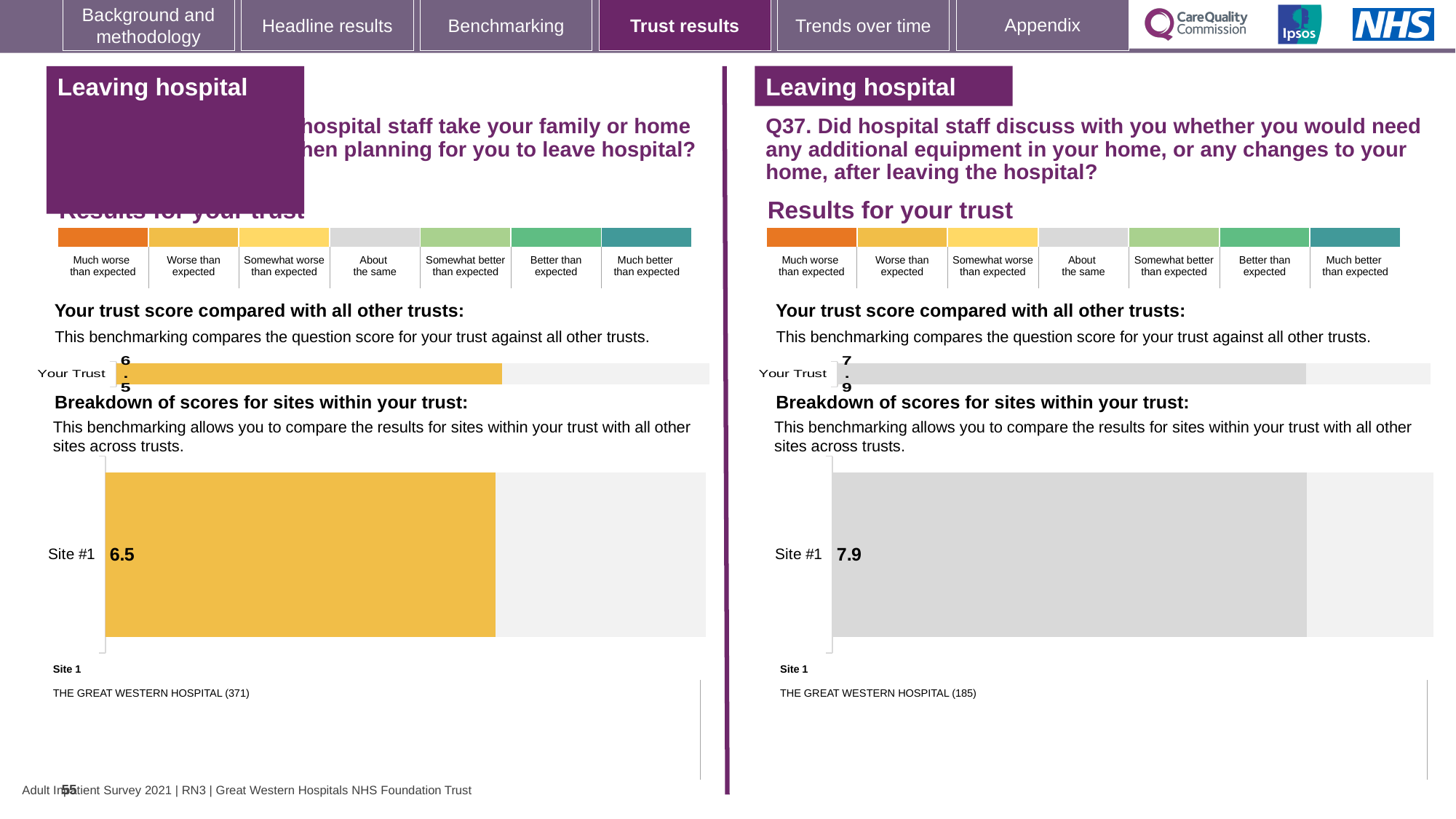
On the left half of the slide, what is the score shown for Your Trust? 6.5 Which site name is listed as Site 1 under the right chart (Q37)? THE GREAT WESTERN HOSPITAL (185) In the left 'Breakdown of scores for sites within your trust' chart, what is the score for Site #1? 6.5 What kind of chart is used to show the Site #1 score on the right half of the slide (Q37)? Bar chart In the right 'Breakdown of scores for sites within your trust' chart (Q37), what is the score for Site #1? 7.9 On the right half of the slide (Q37), what is the score shown for Your Trust? 7.9 Which is larger: the Your Trust score on the left half of the slide or the Your Trust score on the right half (Q37)? Right half (Q37) What is the difference between the Site #1 score on the right half (Q37) and the Site #1 score on the left half of the slide? 1.4 What colour is the Site #1 bar in the left 'Breakdown of scores for sites within your trust' chart? Yellow What colour is the Site #1 bar in the right 'Breakdown of scores for sites within your trust' chart (Q37)? Grey How many sites are shown in the right 'Breakdown of scores for sites within your trust' chart (Q37)? 1 How many sites are shown in the left 'Breakdown of scores for sites within your trust' chart? 1